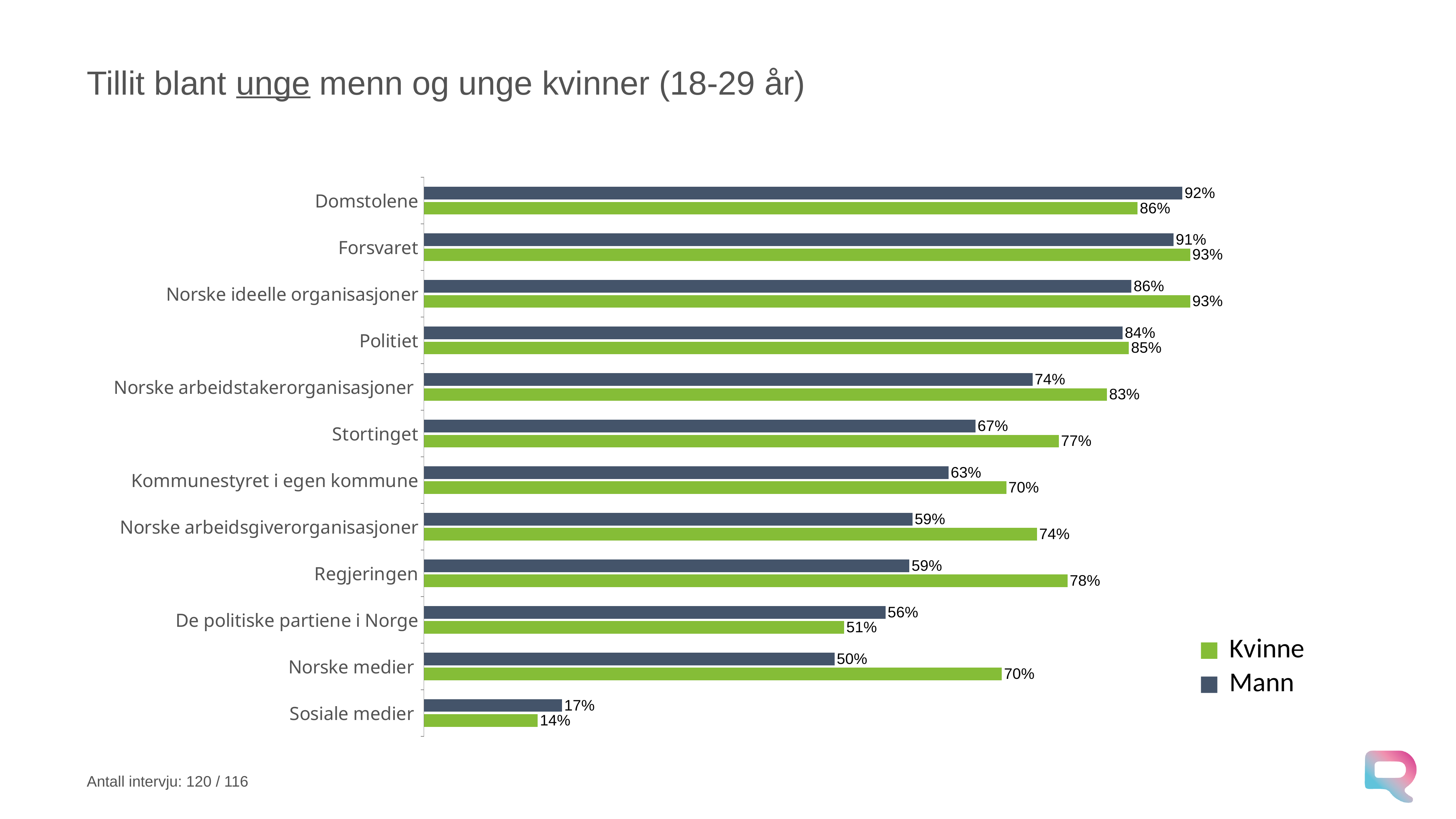
What is the difference between the Kvinne and Mann values for Norske medier? 20% What is the Mann value for Domstolene? 92% What kind of chart is shown on the slide? Bar chart Which category has the highest Mann value? Domstolene What is the Mann value for Stortinget? 67% What is the Kvinne value for Regjeringen? 78% What is the difference between the Mann and Kvinne values for Domstolene? 6% Which category has the lowest Kvinne value? Sosiale medier How many series does the legend list? 2 What is the Kvinne value for Norske medier? 70% For De politiske partiene i Norge, which is larger, the Kvinne value or the Mann value? Mann How many categories are shown on the chart? 12